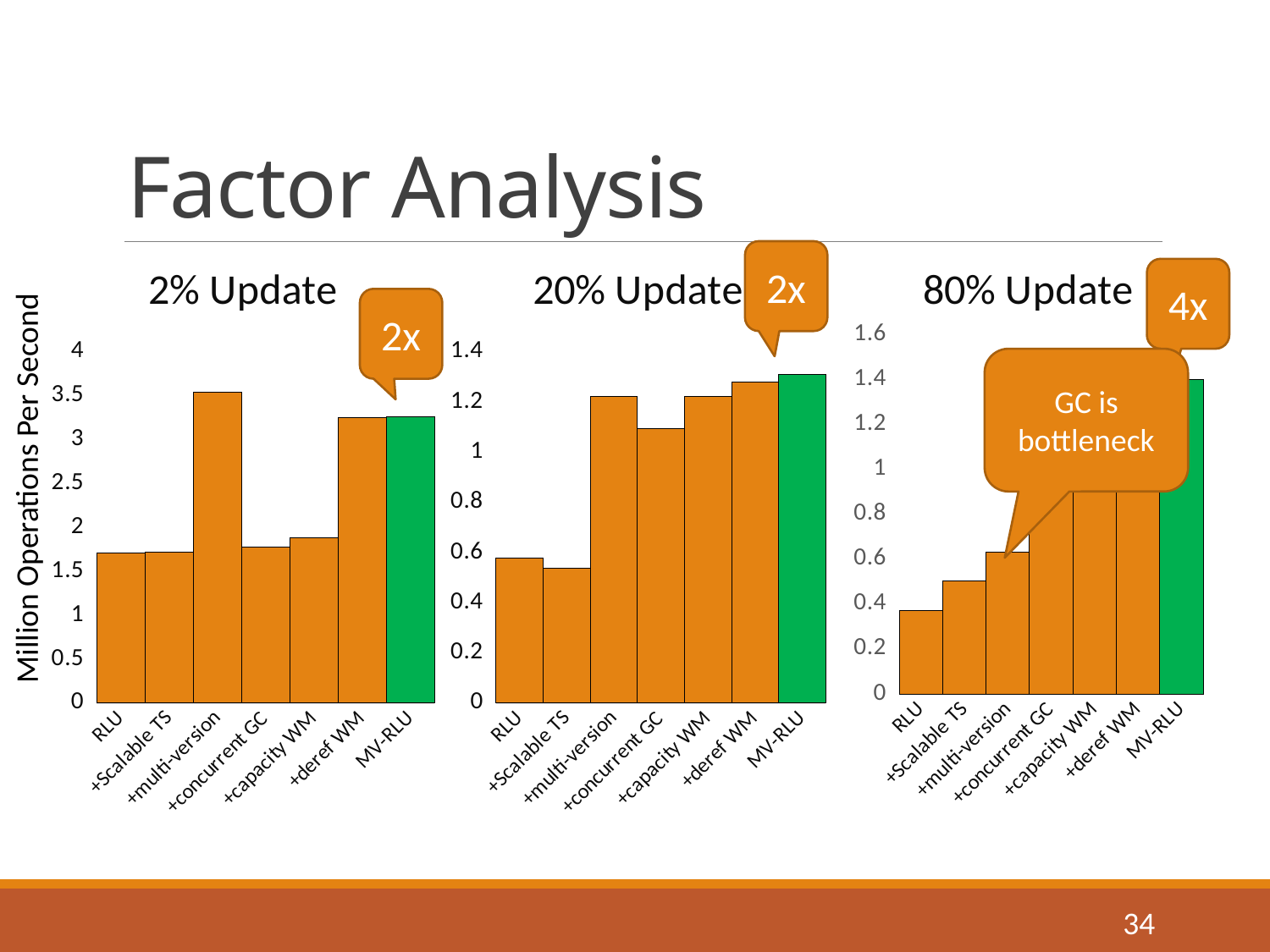
In the "2% Update" chart, is the value for MV-RLU greater or less than 3? greater In the "20% Update" chart, which is larger, the value for +multi-version or the value for +concurrent GC? +multi-version In the "80% Update" chart, do the values generally rise or fall from RLU to MV-RLU along the x axis? rise What does the callout on the "80% Update" chart say is the bottleneck? GC In the "80% Update" chart, which category has the highest value? MV-RLU How many categories are shown on the x axis of the "80% Update" chart? 7 What is the y-axis label shown on the left of the slide? Million Operations Per Second In the "20% Update" chart, is the value for +multi-version greater or less than 1? greater In the "2% Update" chart, which category has the highest value? +multi-version In the "80% Update" chart, which category has the lowest value? RLU In the "2% Update" chart, is the value for RLU greater or less than 2? less What kind of chart is the "2% Update" chart? bar chart